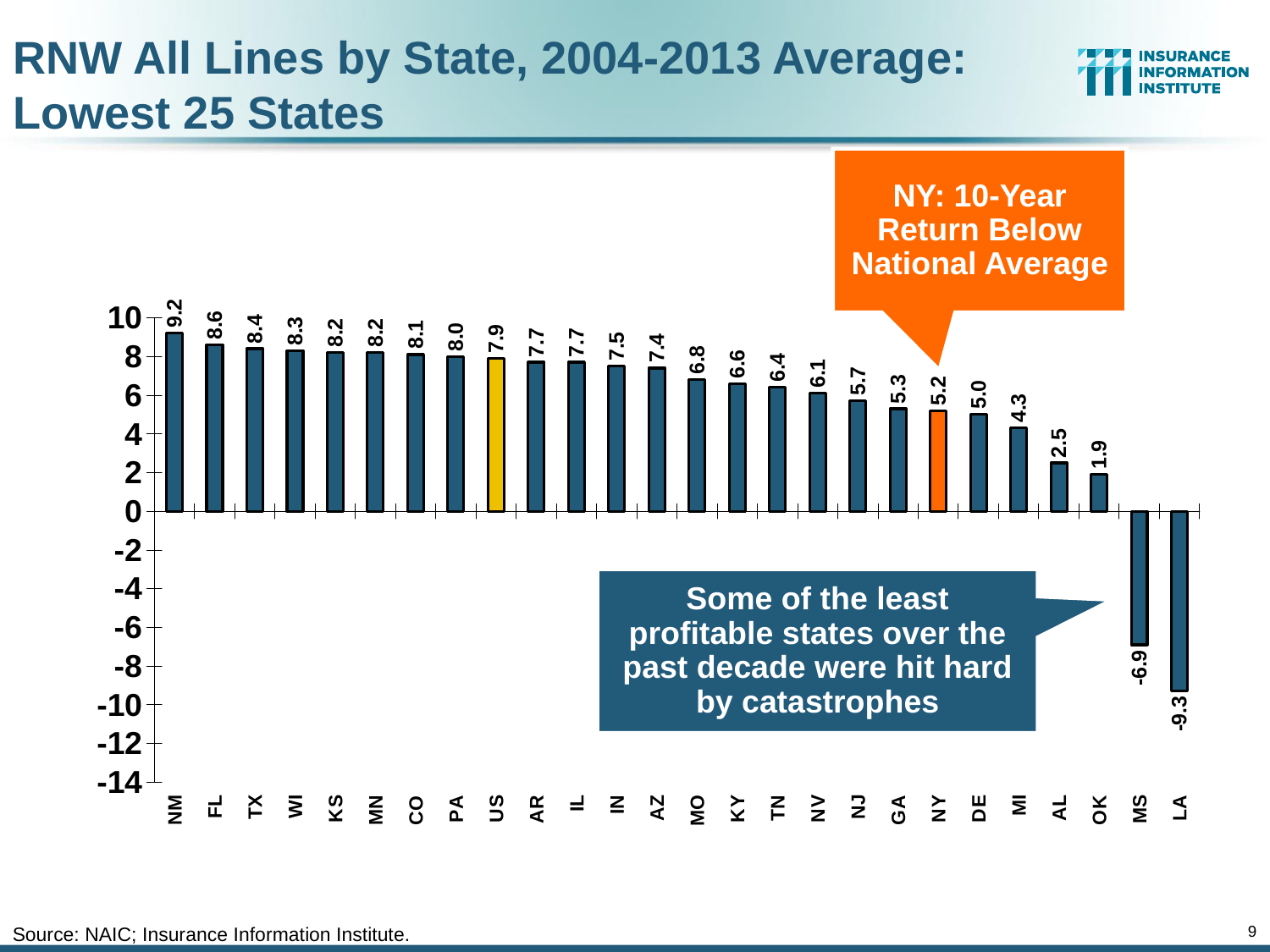
Which category has the highest value? NM What is the value for NY? 5.2 What is the difference between the US value and the NY value? 2.7 What kind of chart is shown? Bar chart Which is larger, the value for FL or the value for TX? FL What is the value for the US bar? 7.9 What is the value for LA? -9.3 What is the value for MS? -6.9 How many bars are plotted on the chart? 26 Do the values generally rise or fall moving from left to right along the x axis? Fall What is the difference between the values for NM and LA? 18.5 Which category has the lowest value? LA